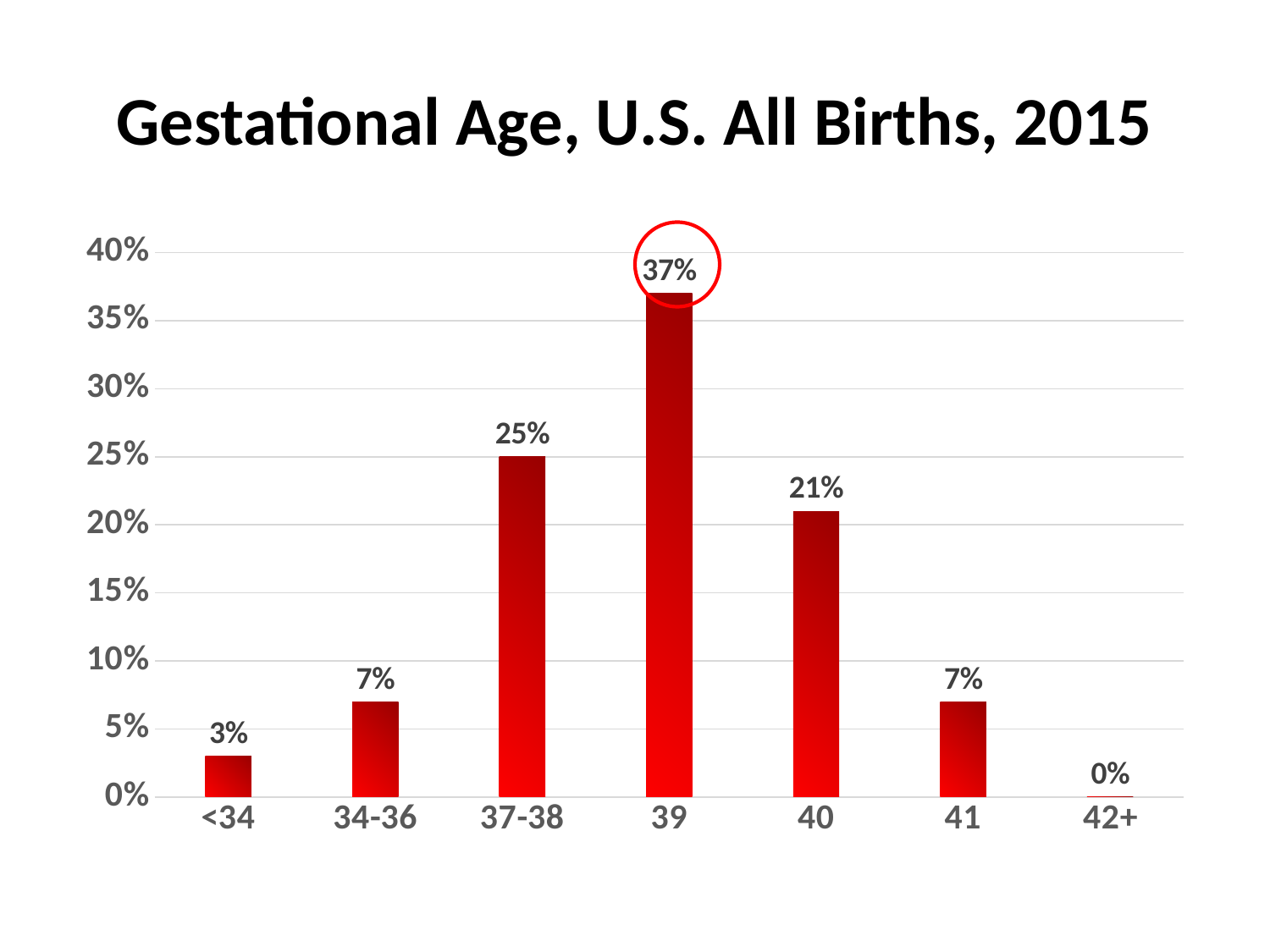
Which data label is circled in red on the chart? 37% What is the value for the 42+ category? 0% How many gestational age categories are shown on the x axis? 7 What is the value for the 37-38 category? 25% What kind of chart is shown on the slide? Bar chart What is the difference between the values for 39 and 40? 16% What percentage of births were at gestational age 39 weeks? 37% What is the value for the <34 category? 3% Which gestational age category has the lowest percentage? 42+ Which gestational age category has the highest percentage? 39 What is the title of the chart? Gestational Age, U.S. All Births, 2015 Which is larger, the value for 37-38 or the value for 40? 37-38